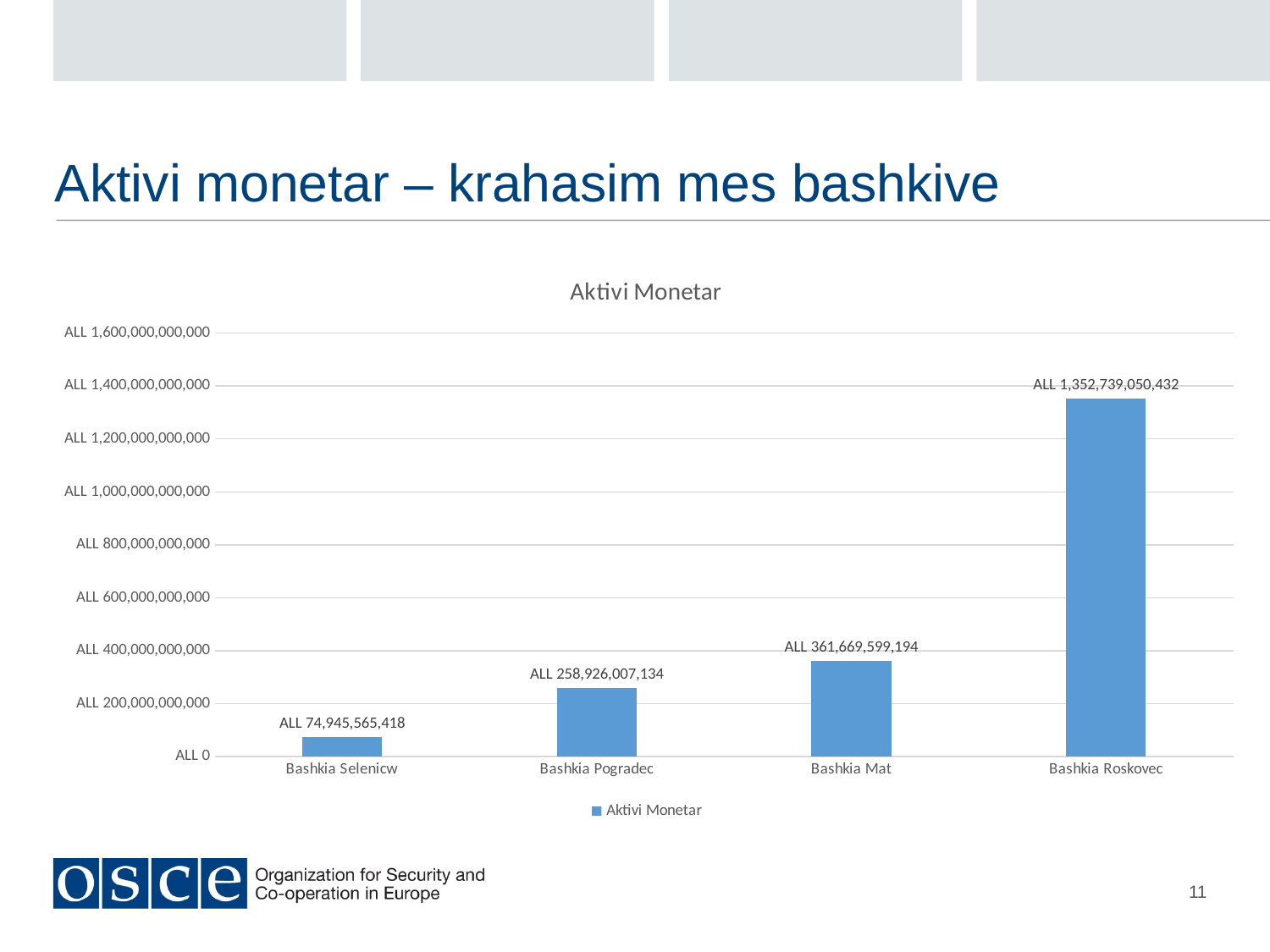
What is the value for Bashkia Selenicw? ALL 74,945,565,418 Which bashkia has the highest Aktivi Monetar? Bashkia Roskovec Which is larger, the value for Bashkia Mat or the value for Bashkia Pogradec? Bashkia Mat How many bashkia are shown on the chart? 4 What is the value for Bashkia Pogradec? ALL 258,926,007,134 Is the value for Bashkia Roskovec greater or less than ALL 1,200,000,000,000? greater Which bashkia has the lowest Aktivi Monetar? Bashkia Selenicw What is the difference between the values for Bashkia Roskovec and Bashkia Mat? ALL 991,069,451,238 What is the difference between the values for Bashkia Mat and Bashkia Pogradec? ALL 102,743,592,060 What is the value for Bashkia Roskovec? ALL 1,352,739,050,432 What is the value for Bashkia Mat? ALL 361,669,599,194 What kind of chart is shown on the slide? bar chart